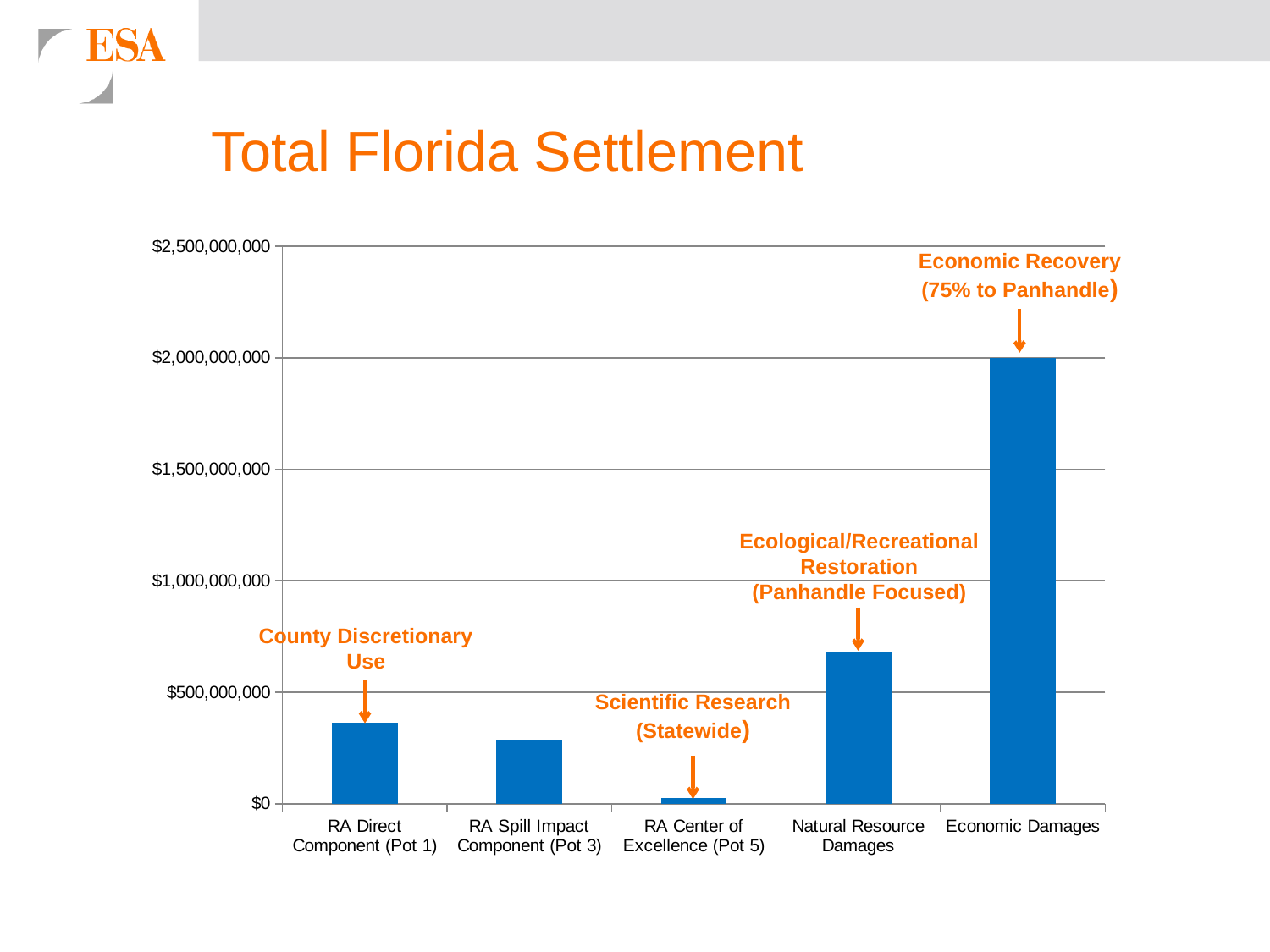
What annotation label points to the Economic Damages bar? Economic Recovery (75% to Panhandle) Which is larger, the value for RA Direct Component (Pot 1) or RA Spill Impact Component (Pot 3)? RA Direct Component (Pot 1) Which is larger, the value for Natural Resource Damages or RA Spill Impact Component (Pot 3)? Natural Resource Damages Which category has the highest value? Economic Damages Is the value for RA Direct Component (Pot 1) greater or less than $500,000,000? less Which category has the lowest value? RA Center of Excellence (Pot 5) How many categories are plotted on the chart? 5 Is the value for Natural Resource Damages greater or less than $1,000,000,000? less Is the value for Natural Resource Damages greater or less than $500,000,000? greater What kind of chart is shown on the slide? bar chart What is the value for Economic Damages? $2,000,000,000 What is the title of the chart? Total Florida Settlement